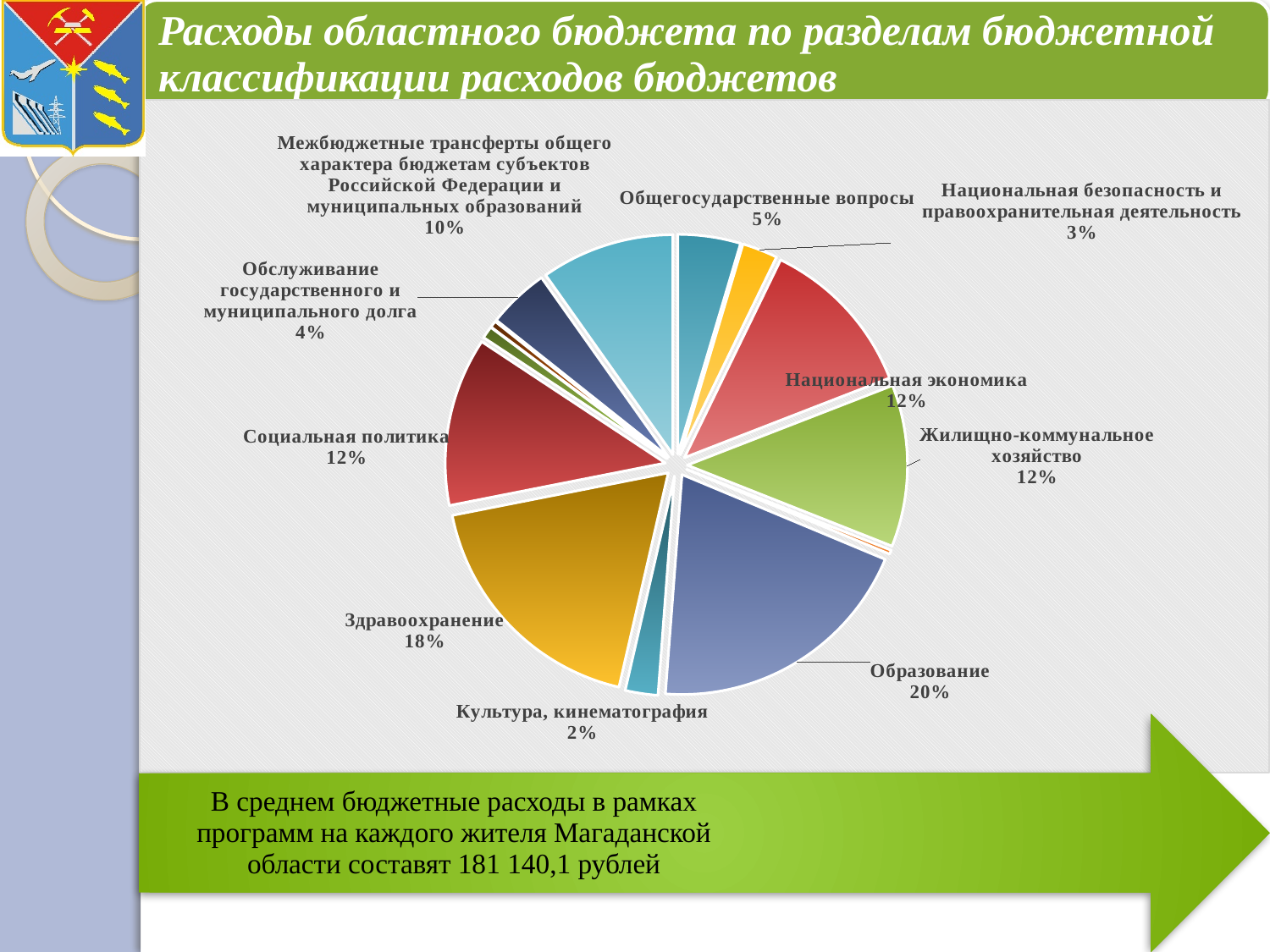
Which labelled section has the largest share of the budget expenditure? Образование What share of the budget expenditure goes to Национальная безопасность и правоохранительная деятельность? 3% What is the title of the slide containing the chart? Расходы областного бюджета по разделам бюджетной классификации расходов бюджетов What share of the budget expenditure goes to Здравоохранение? 18% Which has the larger share: Общегосударственные вопросы or Национальная безопасность и правоохранительная деятельность? Общегосударственные вопросы Which has the larger share: Здравоохранение or Социальная политика? Здравоохранение What share of the budget expenditure goes to Культура, кинематография? 2% By how many percentage points does the share for Образование exceed the share for Здравоохранение? 2 What kind of chart is shown on the slide? pie chart What share of the budget expenditure goes to Образование? 20% What share of the budget expenditure goes to Межбюджетные трансферты общего характера бюджетам субъектов Российской Федерации и муниципальных образований? 10% What share of the budget expenditure goes to Обслуживание государственного и муниципального долга? 4%